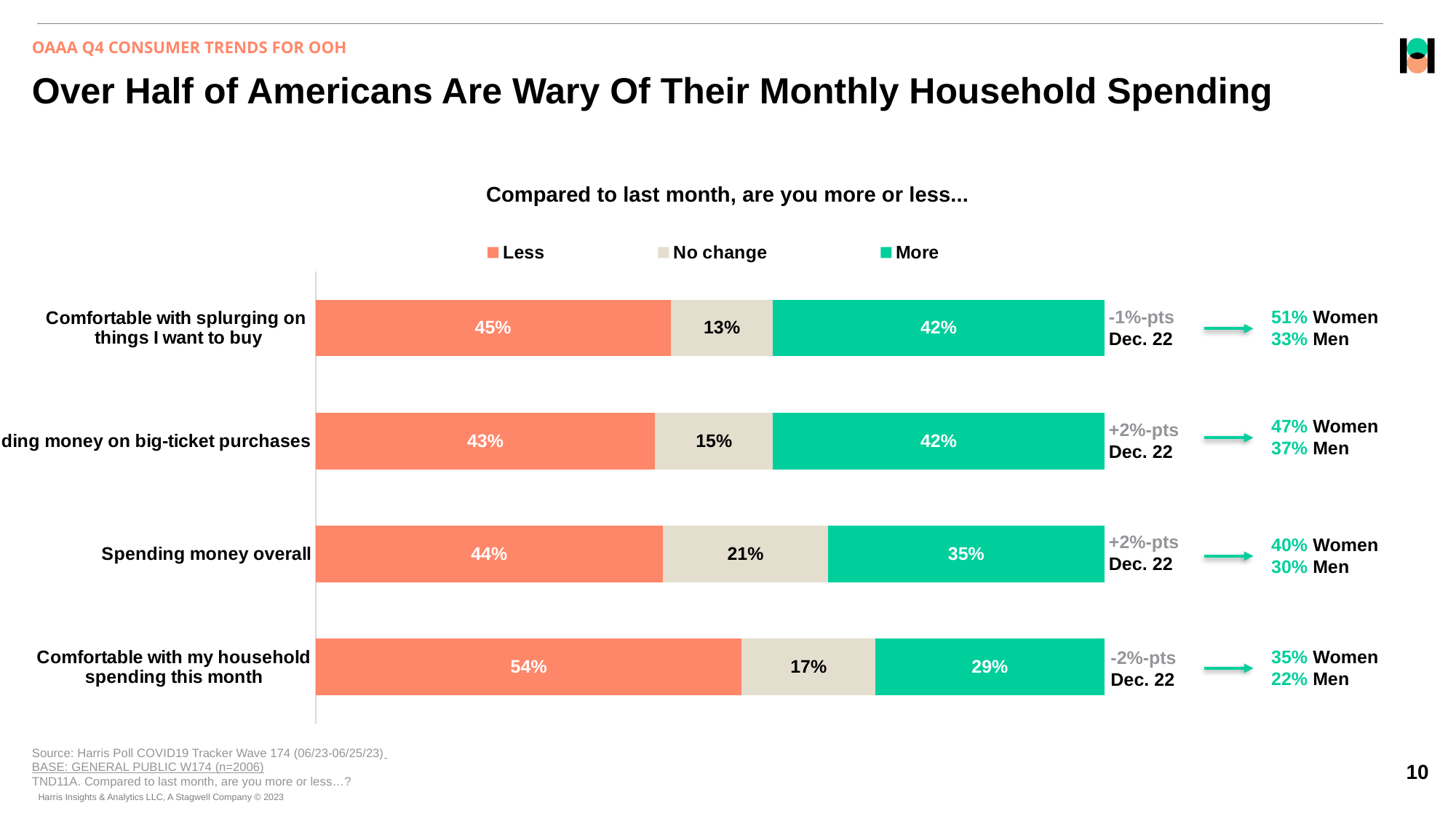
Which category has the lowest 'More' value? Comfortable with my household spending this month What is the 'No change' value for 'Spending money overall'? 21% What is the total of the three segments in the 'Comfortable with my household spending this month' bar? 100% How many series does the chart legend list? 3 What is the title of the chart? Compared to last month, are you more or less... Which is larger for 'Comfortable with splurging on things I want to buy': the 'Less' value or the 'More' value? Less Which category has the highest 'Less' value? Comfortable with my household spending this month What is the 'Less' value for 'Comfortable with my household spending this month'? 54% What kind of chart is shown on the slide? Stacked bar chart What is the difference between the 'Less' and 'More' values for 'Spending money overall'? 9% What is the 'More' value for 'Comfortable with splurging on things I want to buy'? 42% How many categories (bars) are plotted in the chart? 4